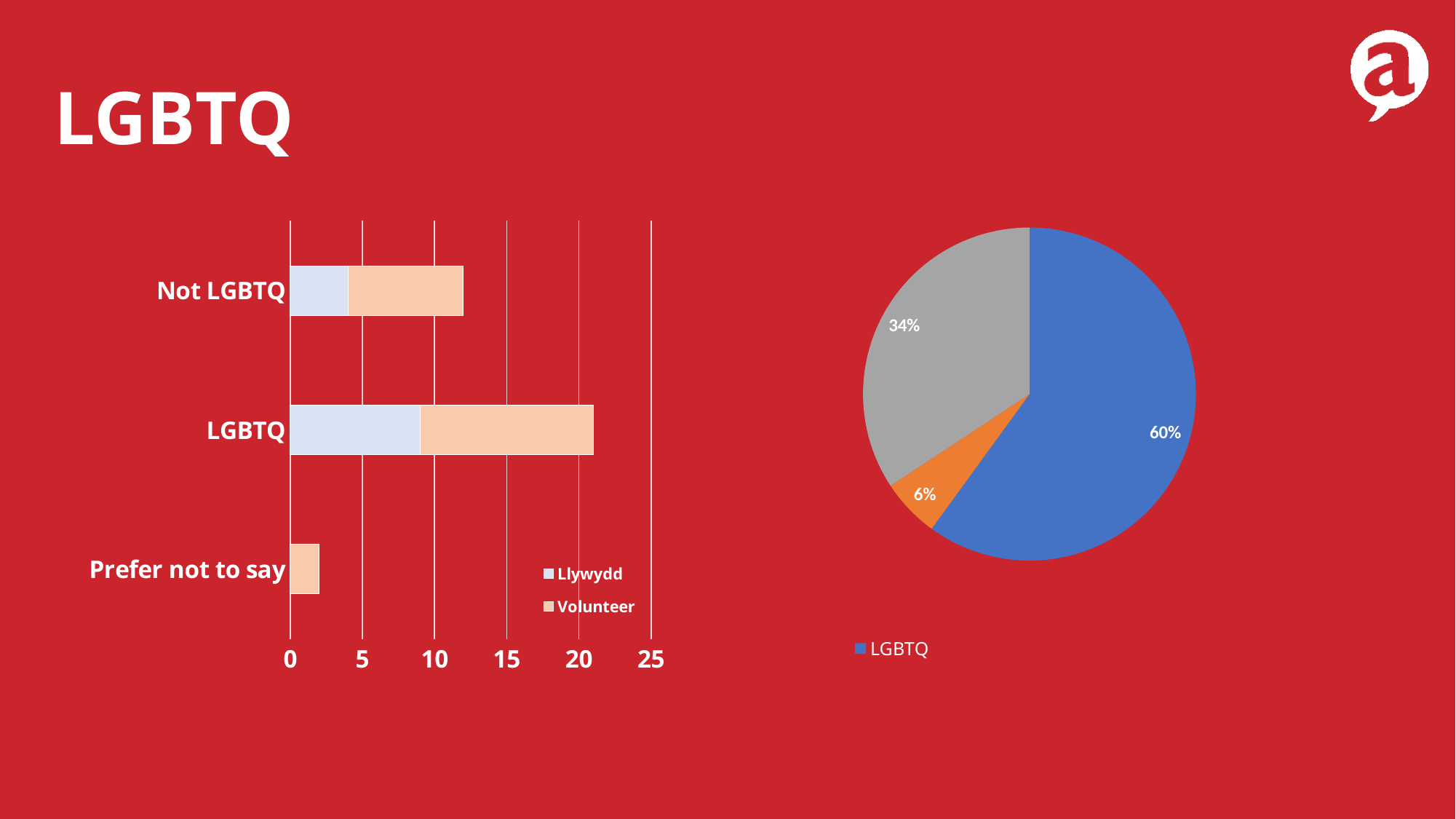
In the pie chart on the right, what share does the largest slice represent? 60% In the pie chart on the right, what is the difference between the largest slice and the grey slice? 26% What kind of chart is the chart on the right of the slide? pie chart In the bar chart on the left, is the total value for Prefer not to say greater or less than 5? less In the bar chart on the left, is the total value for LGBTQ greater or less than 20? greater In the bar chart on the left, which is larger: the total for LGBTQ or the total for Not LGBTQ? LGBTQ What kind of chart is the chart on the left of the slide? bar chart In the bar chart on the left, which category has the longest total bar? LGBTQ In the bar chart on the left, which category has the shortest total bar? Prefer not to say In the bar chart on the left, how many series does the legend list? 2 In the bar chart on the left, how many categories are shown? 3 In the bar chart on the left, is the total value for Not LGBTQ greater or less than 15? less